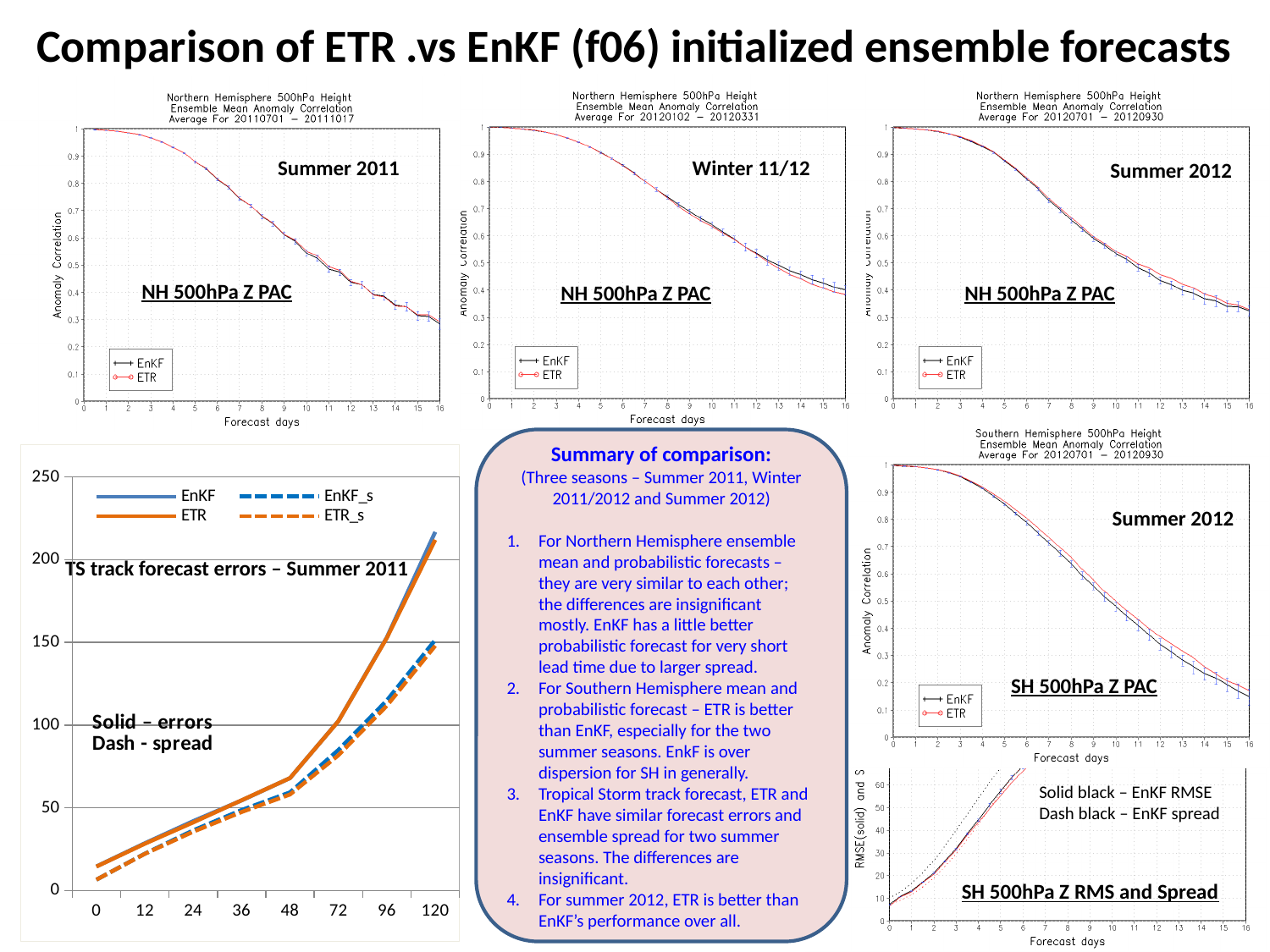
On the 'SH 500hPa Z RMS and Spread' chart (bottom right), what does the solid black line represent? EnKF RMSE How many forecast-hour points are labelled on the x axis of the 'TS track forecast errors – Summer 2011' chart? 8 On the 'TS track forecast errors – Summer 2011' chart, is the EnKF value at 120 hours greater or less than 200? greater Which two series are listed in the legend of the 'Summer 2012' SH 500hPa Z PAC chart? EnKF and ETR On the 'TS track forecast errors – Summer 2011' chart, is the ETR value at 0 hours greater or less than 50? less On the 'Summer 2011' NH 500hPa Z PAC chart (top left), do the anomaly correlation values rise or fall as forecast days increase? fall What kind of chart is the 'TS track forecast errors – Summer 2011' chart at the bottom left? line chart On the 'TS track forecast errors – Summer 2011' chart, is the EnKF_s value at 96 hours greater or less than 100? greater On the 'TS track forecast errors – Summer 2011' chart, do the values rise or fall as forecast hours increase? rise How many series does the legend list on the 'Winter 11/12' NH 500hPa Z PAC chart? 2 How many series does the legend list on the 'TS track forecast errors – Summer 2011' chart? 4